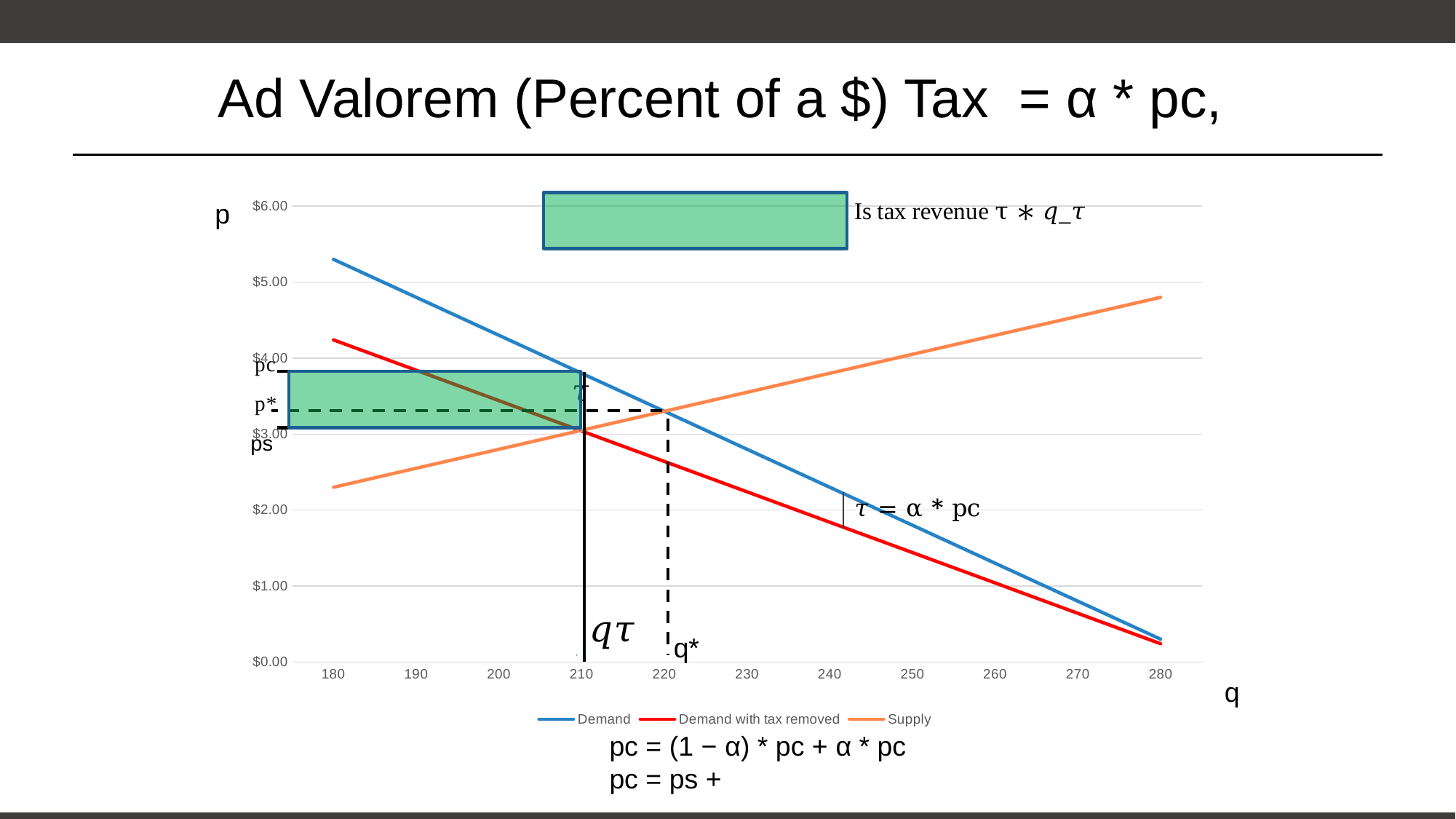
What colour is the Supply line in the chart? orange What are the three series named in the legend? Demand, Demand with tax removed, Supply Is the value of the Demand line at q = 180 greater or less than $5.00? greater Is the value of the Supply line at q = 180 greater or less than $3.00? less Does the Supply line rise or fall as q increases along the x axis? rises How many series does the chart's legend list? 3 Does the Demand line rise or fall as q increases along the x axis? falls At q = 180, which is higher: the Demand line or the Supply line? Demand What kind of chart is shown on the slide? line chart Is the value of the Supply line at q = 280 greater or less than $4.00? greater At q = 280, which is higher: the Supply line or the Demand line? Supply